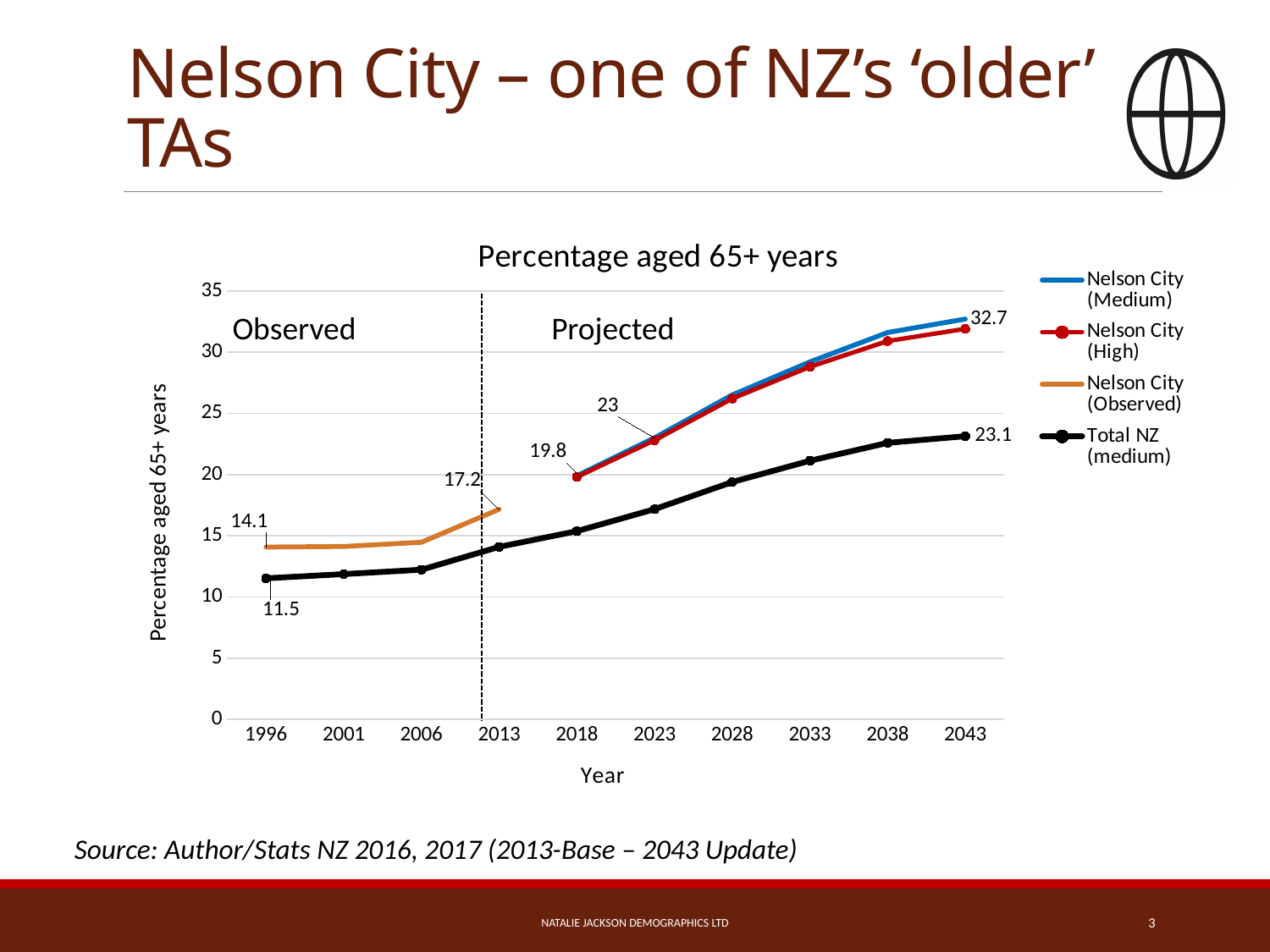
What kind of chart is shown on the slide? line chart By how much did Total NZ (medium) rise from its 1996 value of 11.5 to its 2043 value? 11.6 Is the value for Total NZ (medium) in 2023 greater or less than 20? less What is the title of the chart? Percentage aged 65+ years What is the labelled value for Total NZ (medium) in 2043? 23.1 What is the labelled value for Nelson City in 2018 at the start of the projected period? 19.8 In 1996, which is larger: Nelson City (Observed) or Total NZ (medium)? Nelson City (Observed) What is the highest value labelled on the chart? 32.7 How many years are labelled on the x axis of the chart? 10 How many series does the chart legend list? 4 What is the difference between the Nelson City (Observed) values labelled for 2013 and 1996? 3.1 What is the labelled value for Nelson City (Observed) in 1996? 14.1